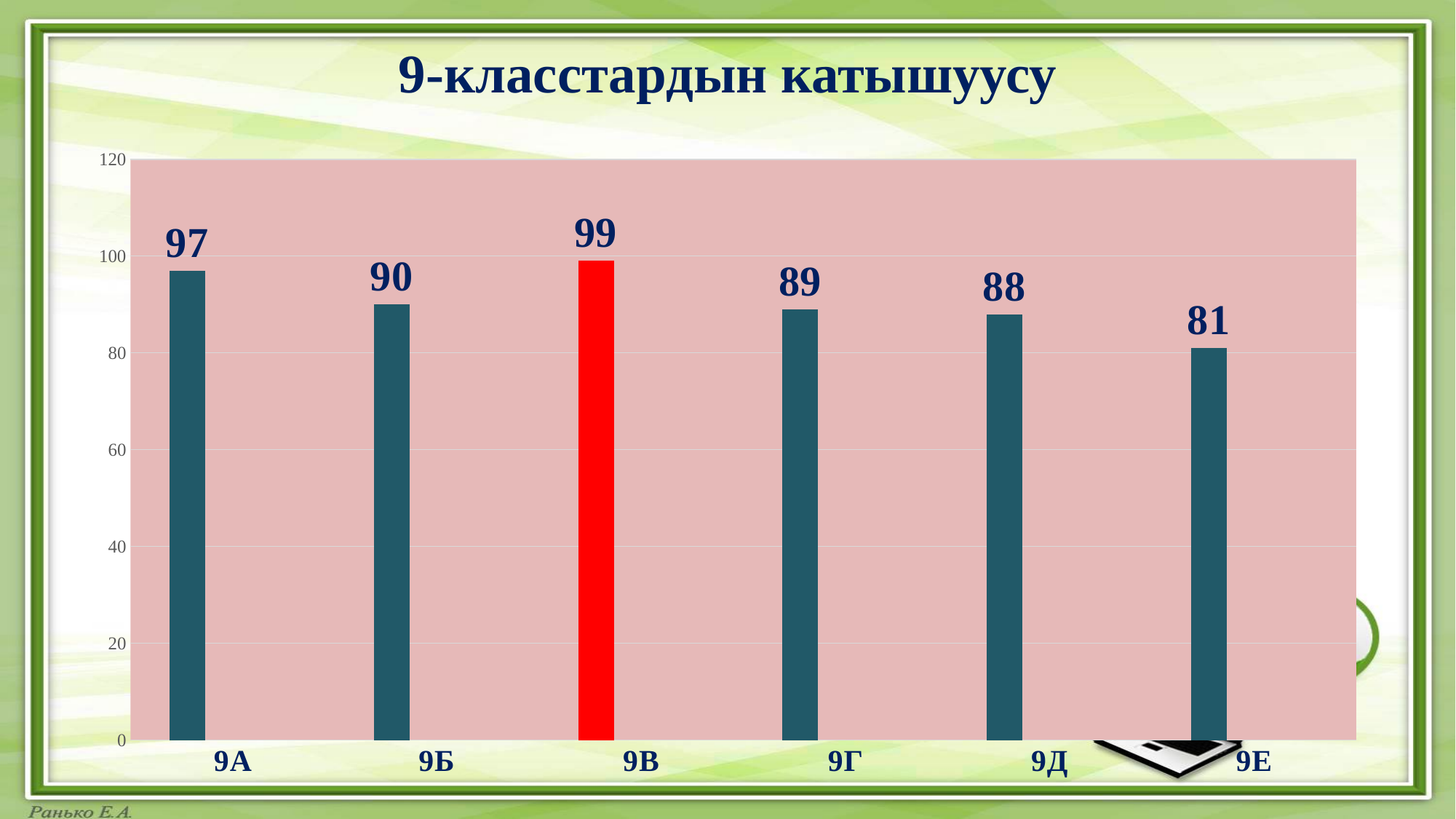
Which bar is coloured red? 9В How many categories are shown on the chart? 6 What is the value for 9А? 97 What is the difference between the values for 9А and 9Б? 7 Which is larger, the value for 9Б or the value for 9Д? 9Б Which category has the lowest value? 9Е What is the value for 9Г? 89 What is the difference between the values for 9В and 9Е? 18 What kind of chart is shown on the slide? bar chart Is the value for 9Д greater or less than 80? greater Which category has the highest value? 9В What is the value for 9Е? 81